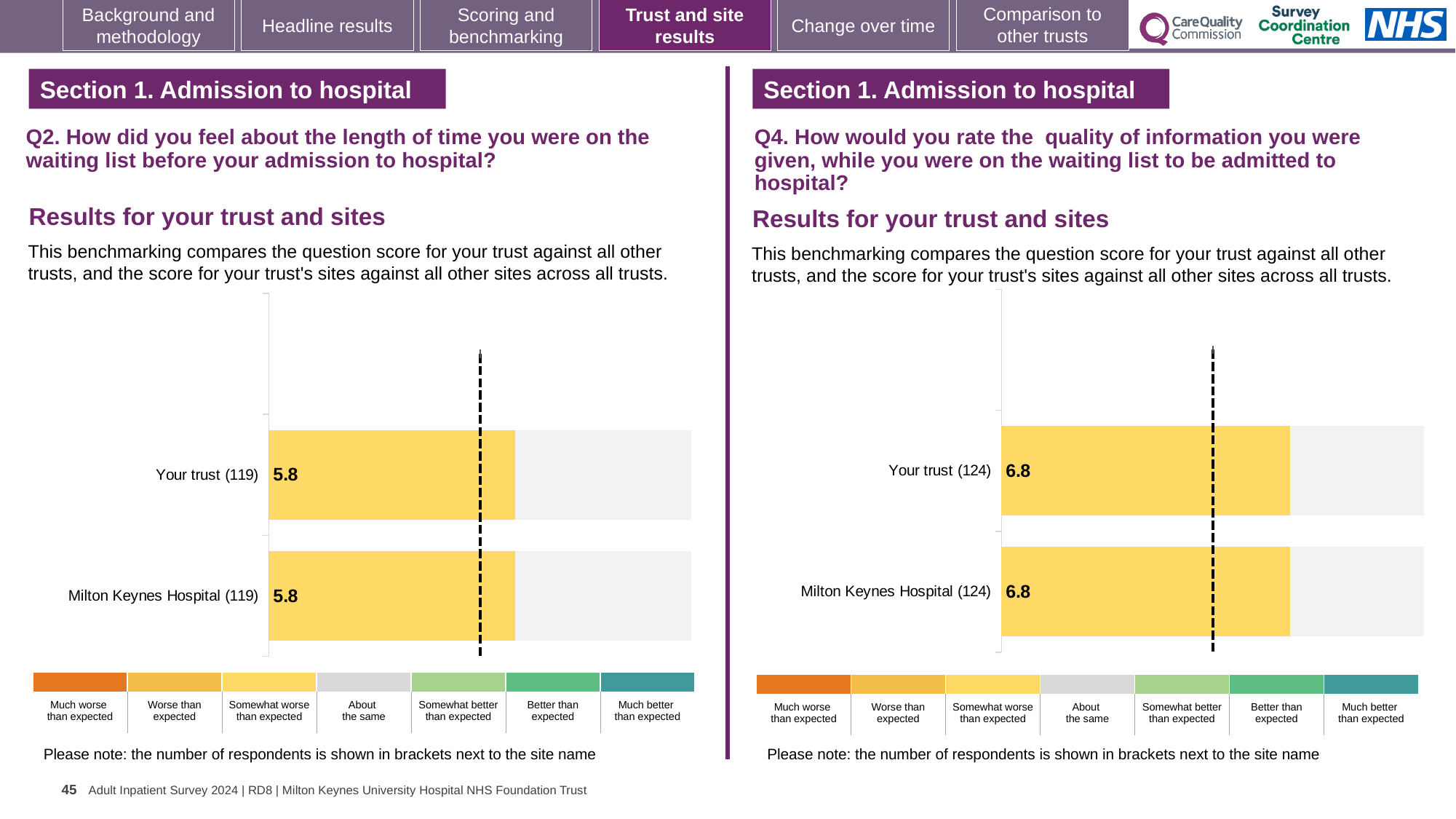
On the right chart (Q4), what is the score for Your trust? 6.8 On the left chart (Q2), what is the score for Your trust? 5.8 Is the score for Your trust on the right chart (Q4) larger or smaller than the score for Your trust on the left chart (Q2)? Larger What kind of chart is used on the left (Q2)? Bar chart How many bars are plotted on the right chart (Q4)? 2 On the right chart (Q4), what is the score for Milton Keynes Hospital? 6.8 On the left chart (Q2), what is the difference between the score for Your trust and the score for Milton Keynes Hospital? 0 On the left chart (Q2), what is the score for Milton Keynes Hospital? 5.8 On the left chart (Q2), how many respondents are shown in brackets for Milton Keynes Hospital? 119 How many bars are plotted on the left chart (Q2)? 2 On the right chart (Q4), what is the difference between the score for Your trust and the score for Milton Keynes Hospital? 0 On the right chart (Q4), how many respondents are shown in brackets for Your trust? 124